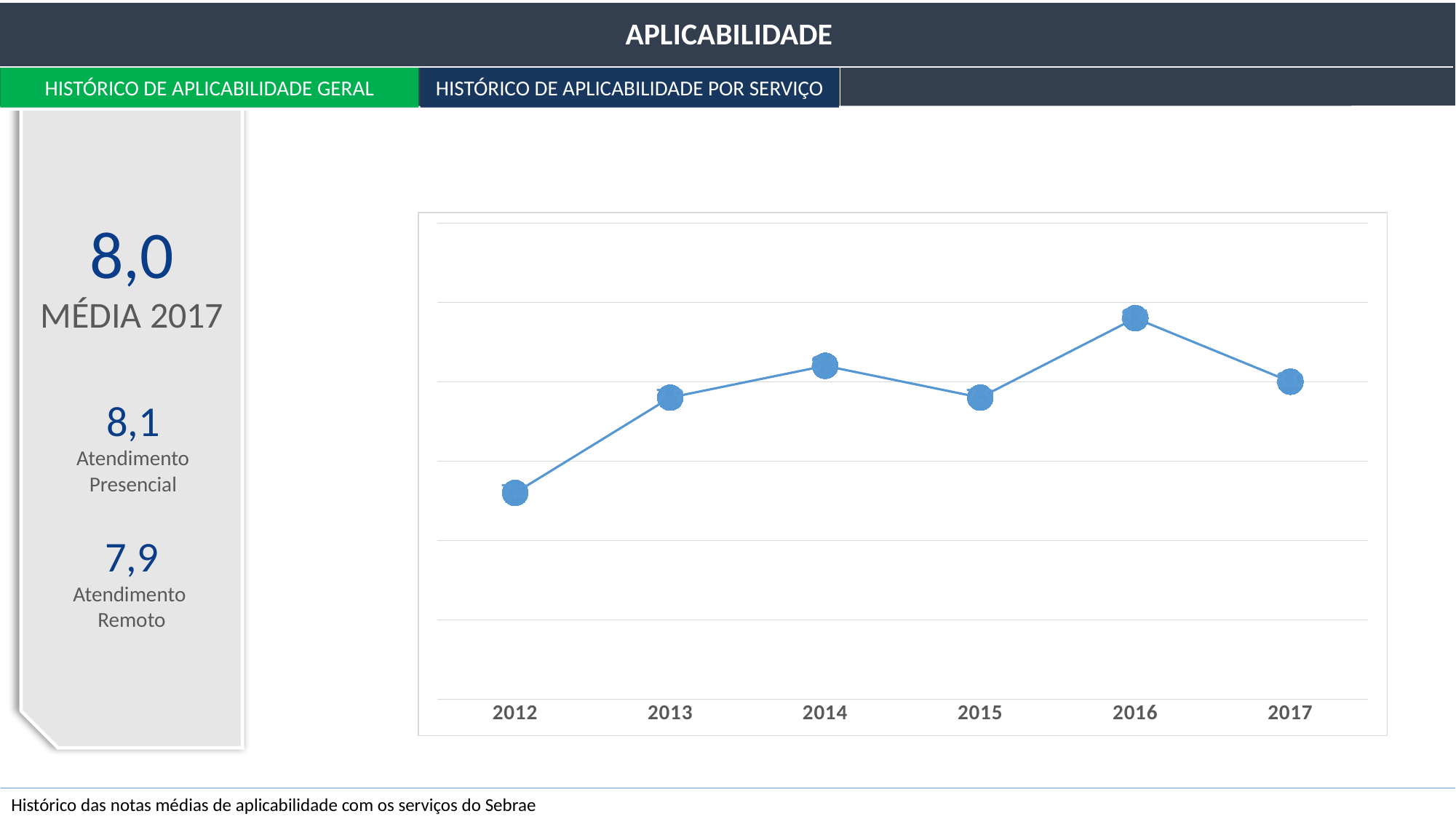
What is the first year shown on the x axis of the chart? 2012 How many years are plotted on the x axis of the chart? 6 Does the value rise or fall from 2012 to 2014? rise Which year has the larger value, 2012 or 2017? 2017 Does the value rise or fall from 2016 to 2017? fall Does the value rise or fall from 2015 to 2016? rise What is the last year shown on the x axis of the chart? 2017 Which year has the larger value, 2014 or 2015? 2014 Which year has the larger value, 2016 or 2014? 2016 Which year has the highest value in the chart? 2016 Which year has the lowest value in the chart? 2012 What kind of chart is shown on the slide? line chart